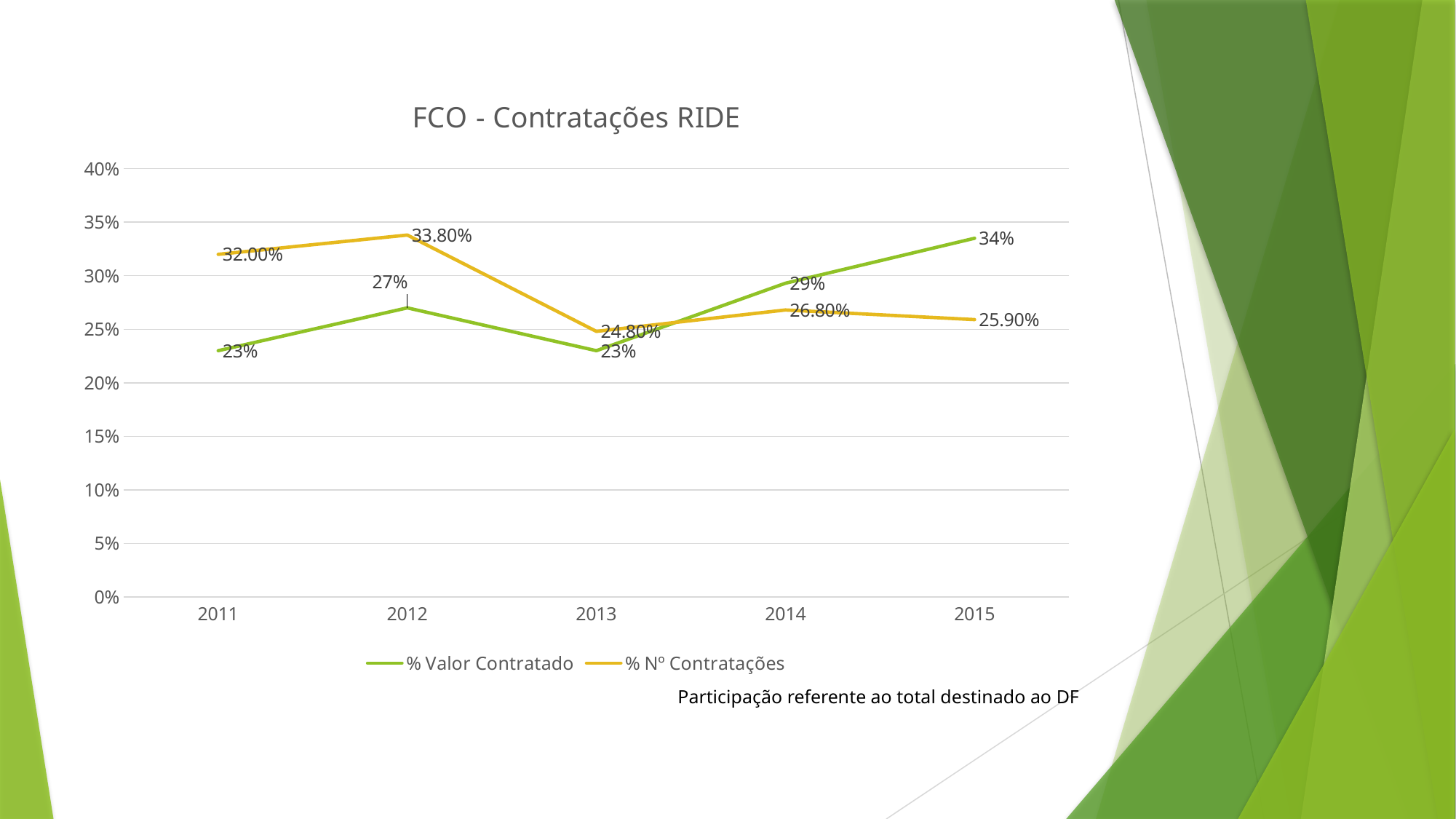
What is the value of % Nº Contratações in 2012? 33.80% What is the title of the chart? FCO - Contratações RIDE What type of chart is shown on the slide? line chart In which year is % Valor Contratado highest? 2015 How many years are shown on the x axis? 5 Does % Valor Contratado rise or fall from 2013 to 2015? rise Which series has the larger value in 2011, % Valor Contratado or % Nº Contratações? % Nº Contratações What is the difference between % Valor Contratado in 2015 and in 2011? 11% What is the value of % Valor Contratado in 2015? 34% What is the value of % Nº Contratações in 2013? 24.80% How many series does the legend list? 2 In which year is % Nº Contratações highest? 2012